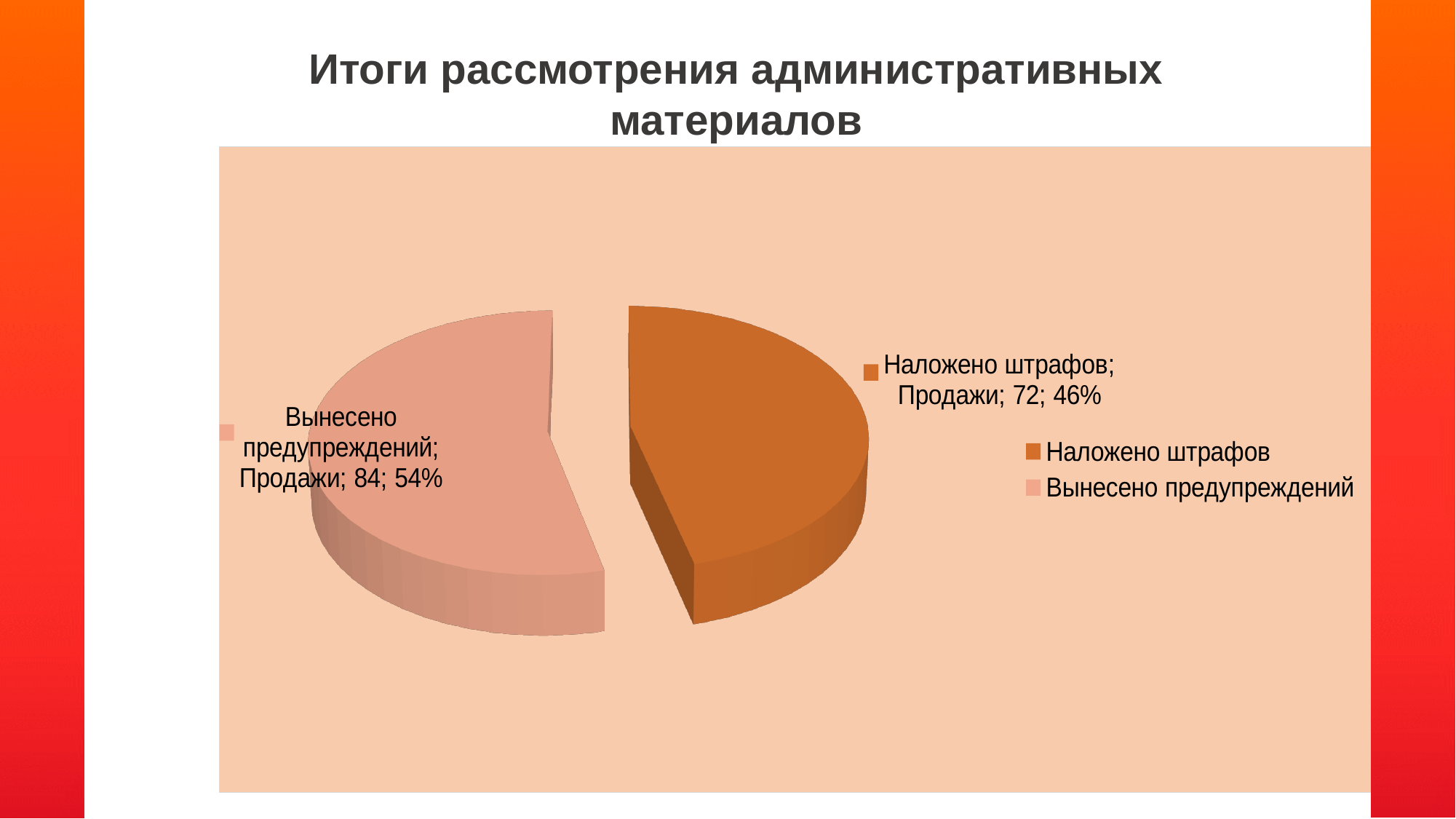
What share of the pie does Наложено штрафов represent? 46% What is the value for Наложено штрафов? 72 What is the title of the slide? Итоги рассмотрения административных материалов What is the difference between the values for Вынесено предупреждений and Наложено штрафов? 12 Which category has the smallest slice? Наложено штрафов What share of the pie does Вынесено предупреждений represent? 54% What is the total of the two slice values? 156 What kind of chart is shown on the slide? pie chart How many slices does the pie chart have? 2 What is the value for Вынесено предупреждений? 84 Which is larger, the value for Наложено штрафов or the value for Вынесено предупреждений? Вынесено предупреждений Which category has the largest slice? Вынесено предупреждений